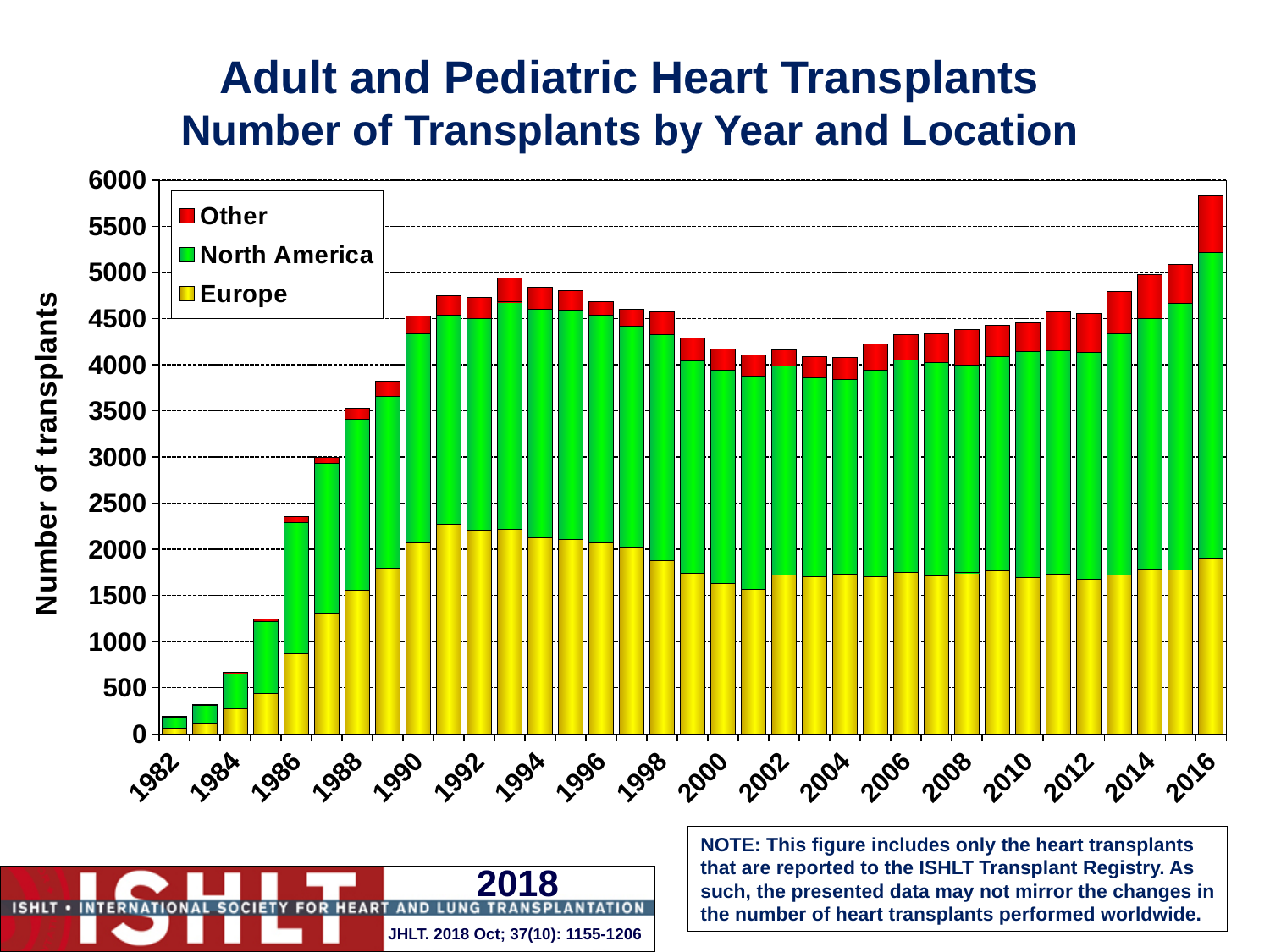
Do total transplants rise or fall from 1982 to 1993? Rise Which colour represents Europe in the chart? Yellow Which year has the highest total number of transplants? 2016 Which year has the larger total number of transplants, 1993 or 2003? 1993 How many series does the legend list? 3 Which year has the lowest total number of transplants? 1982 What kind of chart is shown on the slide? Stacked bar chart Is the total number of transplants in 2016 greater or less than 5500? greater Is the total number of transplants in 2002 greater or less than 4500? less Is the number of transplants in Europe in 1986 greater or less than 500? greater Which three locations are listed in the legend? Other, North America, Europe